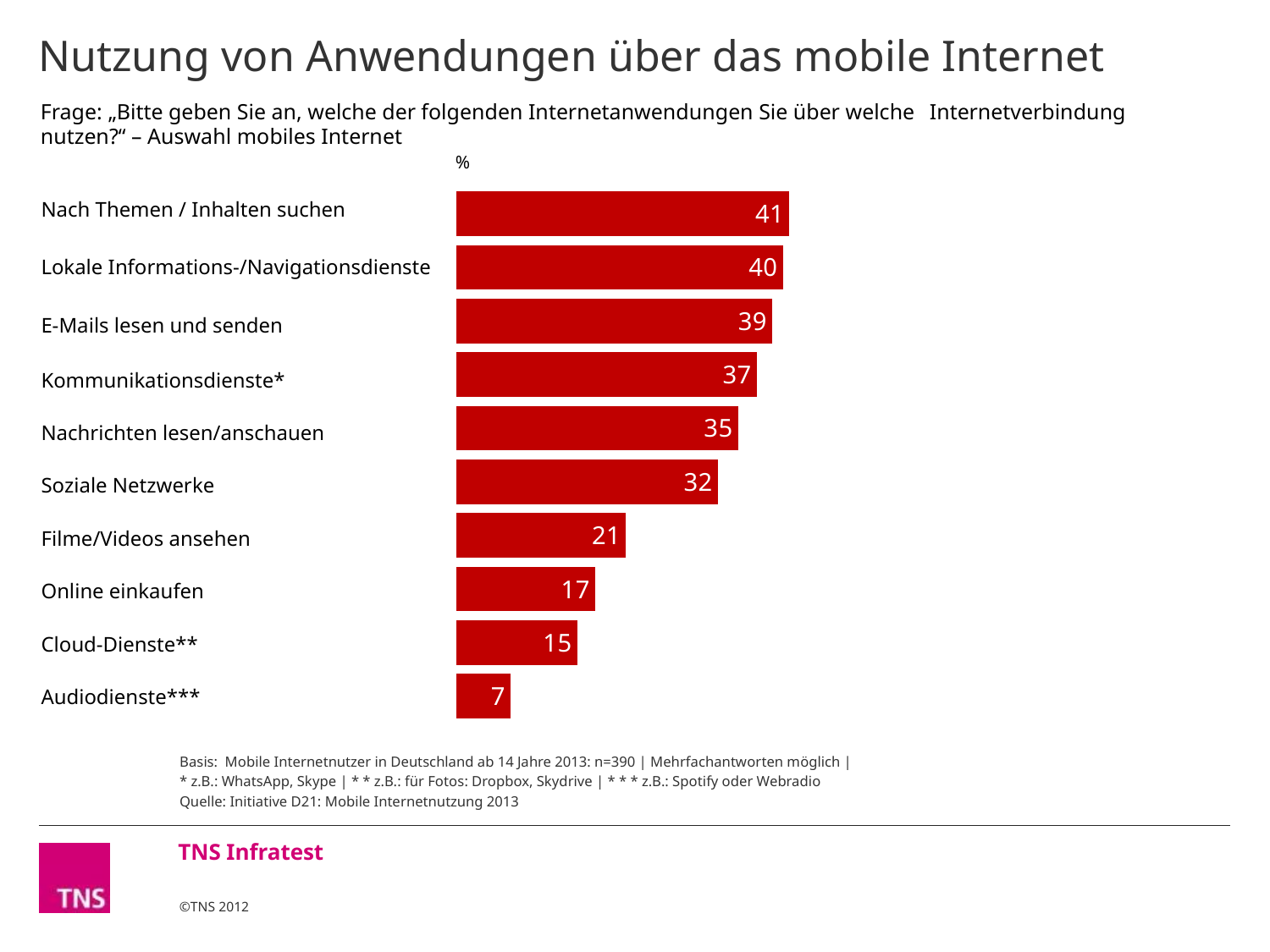
How many categories are shown in the chart? 10 What unit is indicated above the bars? % What is the value for "Cloud-Dienste**"? 15 What is the difference between the values for "Filme/Videos ansehen" and "Online einkaufen"? 4 Which category has the lowest value? Audiodienste*** What is the title of the slide? Nutzung von Anwendungen über das mobile Internet Which category has the highest value? Nach Themen / Inhalten suchen What is the value for "Soziale Netzwerke"? 32 What is the difference between the values for "Nach Themen / Inhalten suchen" and "Audiodienste***"? 34 What kind of chart is shown on the slide? Bar chart What is the value for "E-Mails lesen und senden"? 39 Which is larger, the value for "Nachrichten lesen/anschauen" or the value for "Filme/Videos ansehen"? Nachrichten lesen/anschauen